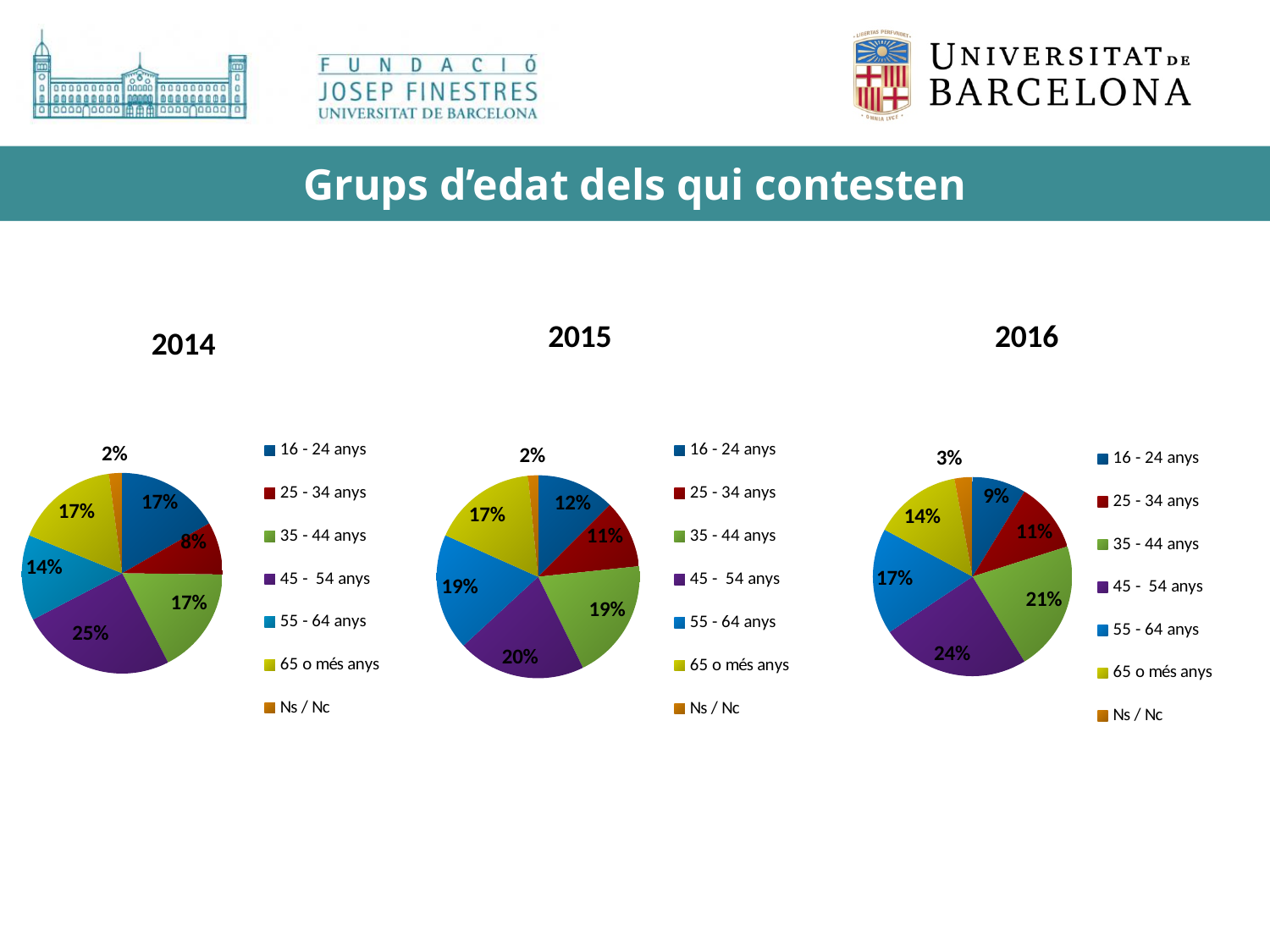
In the 2015 pie chart, which is larger: the 45 - 54 anys slice or the 65 o més anys slice? 45 - 54 anys How many slices does the 2016 pie chart have? 7 In the 2015 pie chart, what share is labelled for the 16 - 24 anys slice? 12% In the 2016 pie chart, what share is labelled for the Ns / Nc slice? 3% In the 2014 pie chart, what share is labelled for the 45 - 54 anys slice? 25% What type of chart is used for 2015? Pie chart In the 2015 pie chart, what is the difference between the 35 - 44 anys share and the 25 - 34 anys share? 8% How many pie charts are shown on the slide? 3 In the 2016 pie chart, what share is labelled for the 35 - 44 anys slice? 21% In the 2014 pie chart, which category has the smallest slice? Ns / Nc In the 2014 pie chart, what is the difference between the 45 - 54 anys share and the 25 - 34 anys share? 17% In the 2016 pie chart, which age group has the largest slice? 45 - 54 anys